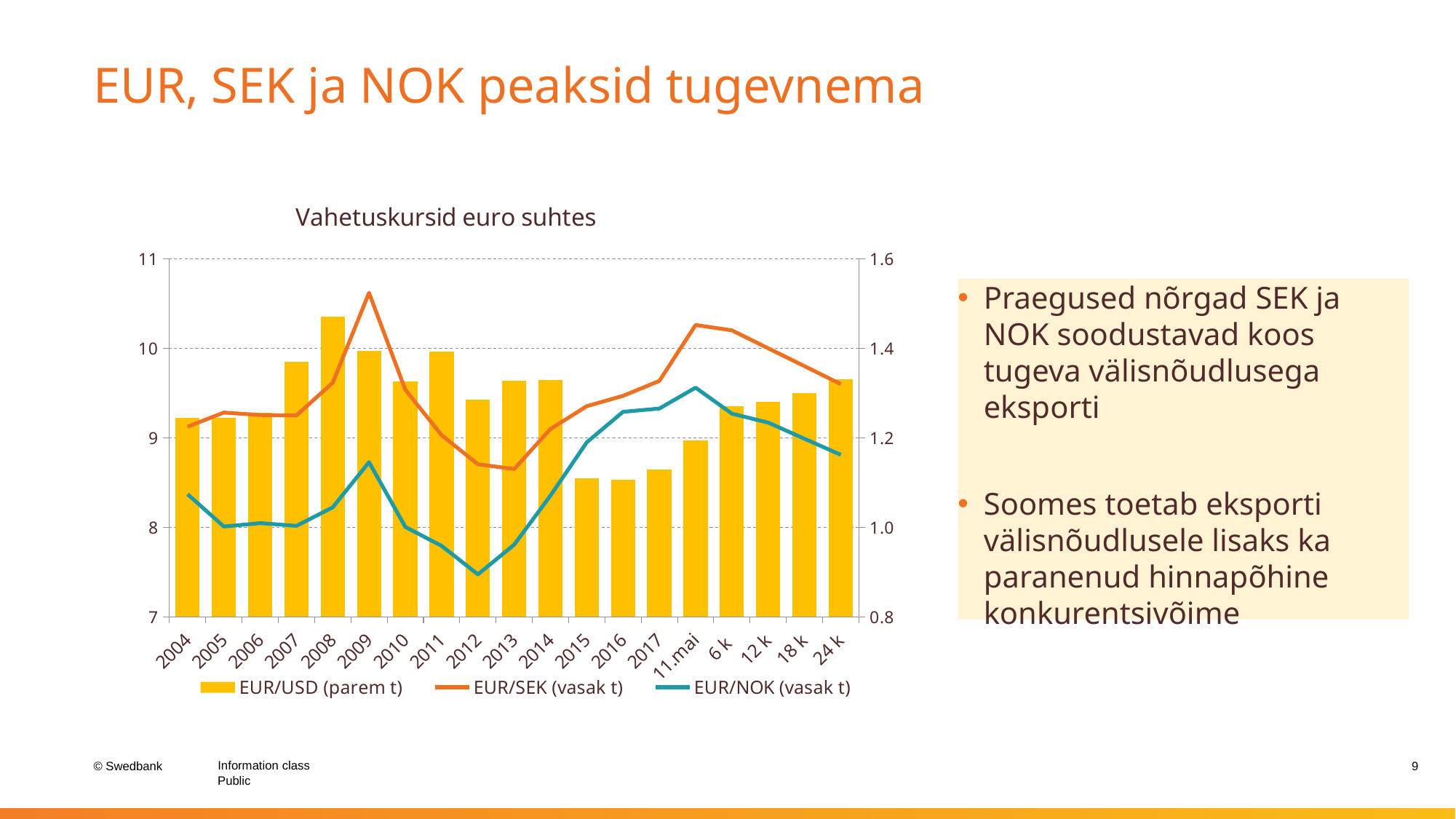
Is the EUR/USD value for 2008 greater or less than 1.4? greater How many categories are shown along the x axis of the chart? 19 In which year is the EUR/USD bar the highest? 2008 How many series does the chart legend list? 3 Which series in the chart is plotted as bars? EUR/USD (parem t) What is the title of the chart? Vahetuskursid euro suhtes Does the EUR/SEK line rise or fall from 11.mai to 24 k? fall In which year does the EUR/NOK line reach its lowest point? 2012 In which year does the EUR/SEK line reach its highest point? 2009 What kind of chart is shown on the slide? Combined bar and line chart Is the EUR/NOK value for 2012 greater or less than 8? less Is the EUR/SEK value for 2009 greater or less than 10? greater